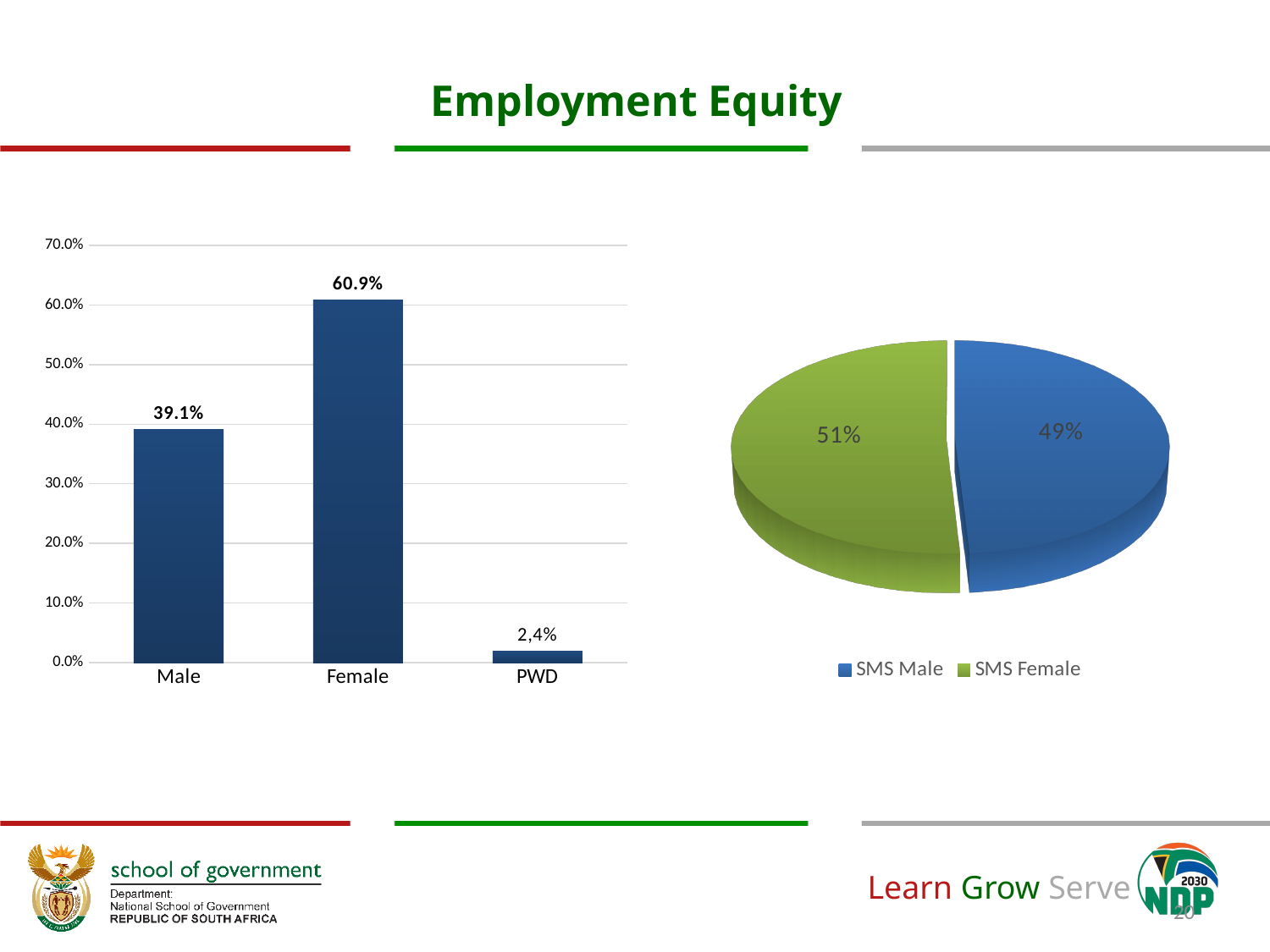
In the pie chart on the right, how many entries does the legend list? 2 In the bar chart on the left, what is the value for PWD? 2,4% In the bar chart on the left, what is the difference between the Female and Male values? 21.8% In the bar chart on the left, how many categories are shown on the x axis? 3 In the bar chart on the left, what is the value for Female? 60.9% In the pie chart on the right, which is larger, SMS Male or SMS Female? SMS Female In the bar chart on the left, which category has the lowest value? PWD What kind of chart is shown on the left of the slide? Bar chart In the bar chart on the left, what is the value for Male? 39.1% In the bar chart on the left, which category has the highest value? Female In the pie chart on the right, what share does SMS Male have? 49% In the pie chart on the right, what share does SMS Female have? 51%